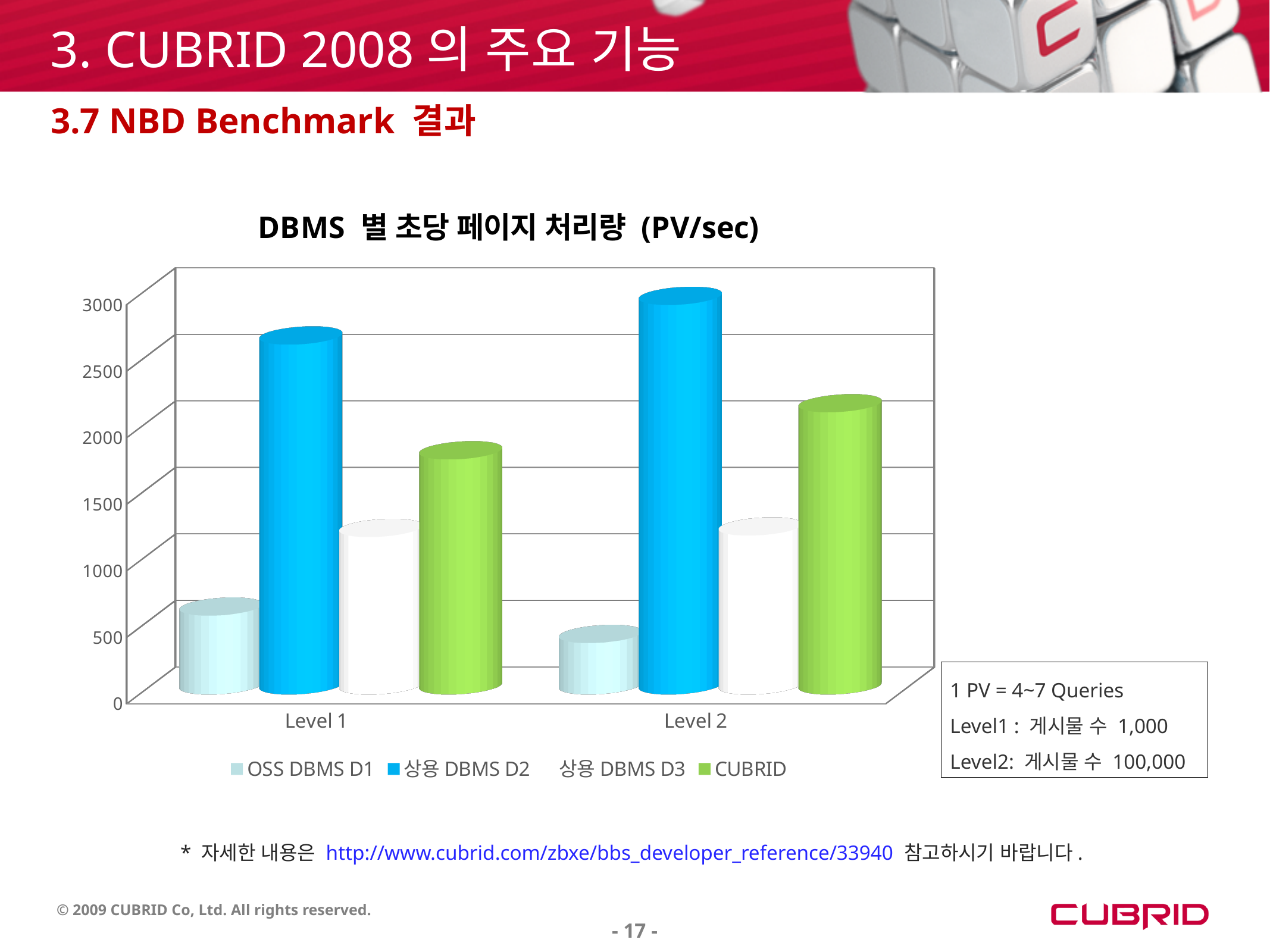
Is the value for OSS DBMS D1 at Level 1 greater or less than 1000? less What is the title of the chart? DBMS 별 초당 페이지 처리량 (PV/sec) What kind of chart is shown on the slide? bar chart Is the value for CUBRID at Level 2 greater or less than 1500? greater Which series has the lowest value for Level 1? OSS DBMS D1 Does the value for 상용 DBMS D2 rise or fall from Level 1 to Level 2? rise For Level 1, which is larger: CUBRID or 상용 DBMS D3? CUBRID Which series has the highest value for Level 2? 상용 DBMS D2 How many series does the legend list? 4 Which series has the lowest value for Level 2? OSS DBMS D1 How many categories are shown on the x axis? 2 Is the value for 상용 DBMS D2 at Level 1 greater or less than 2000? greater